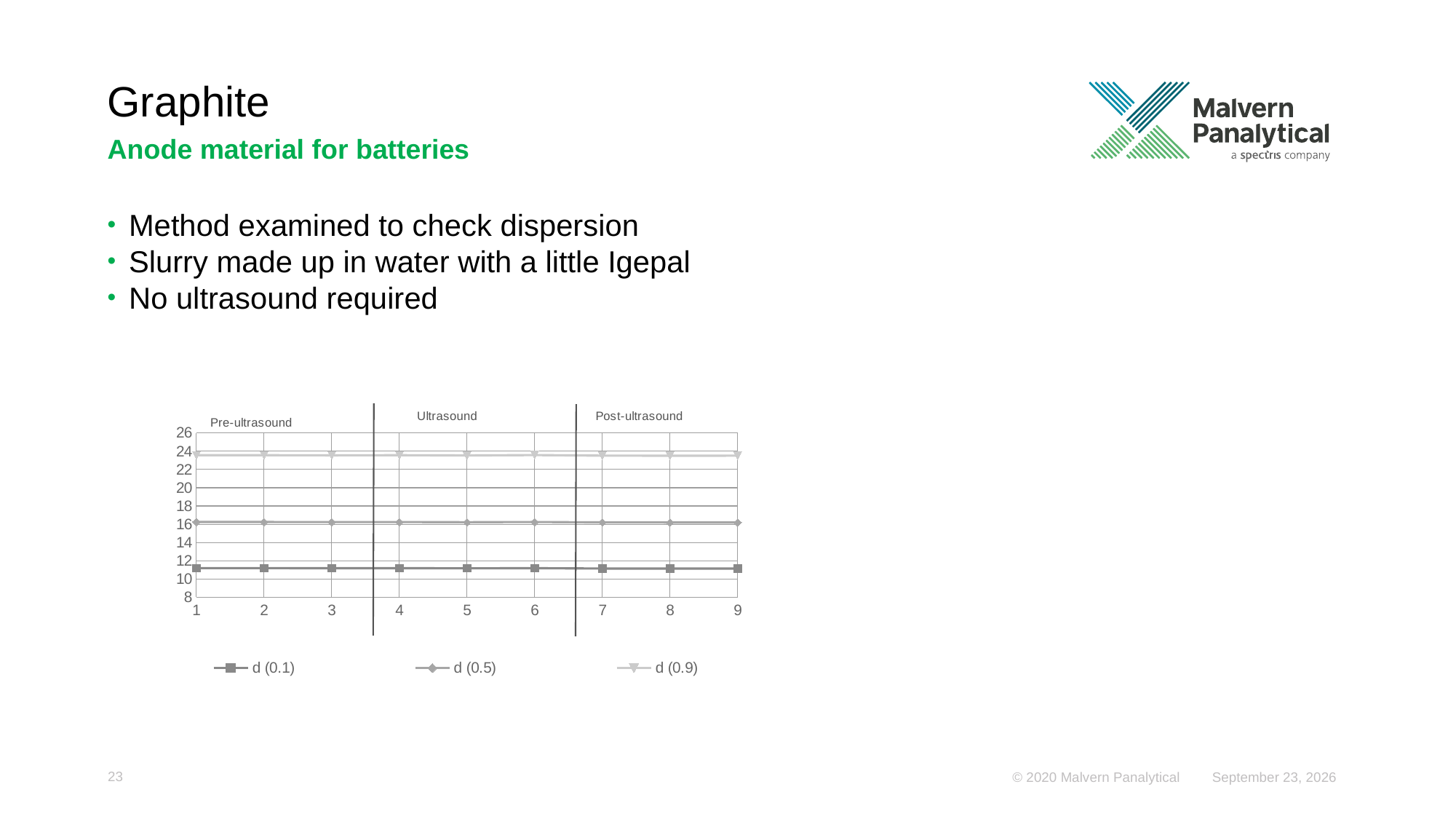
What kind of chart is shown on the slide? line chart What are the three labelled sections along the top of the chart, from left to right? Pre-ultrasound, Ultrasound, Post-ultrasound Is the value for d (0.9) at measurement 5 greater or less than 22? greater Is the value for d (0.5) at measurement 9 greater or less than 14? greater Is the value for d (0.1) at measurement 1 greater or less than 12? less How many measurement points are plotted along the x axis for each series? 9 Do the values for d (0.9) rise, fall, or stay flat from measurement 1 to measurement 9? stay flat Which series has the lowest values on the chart? d (0.1) How many series does the legend list? 3 Which is larger at measurement 4: d (0.5) or d (0.1)? d (0.5) Which series has the highest values on the chart? d (0.9) What is the highest value shown on the y axis? 26